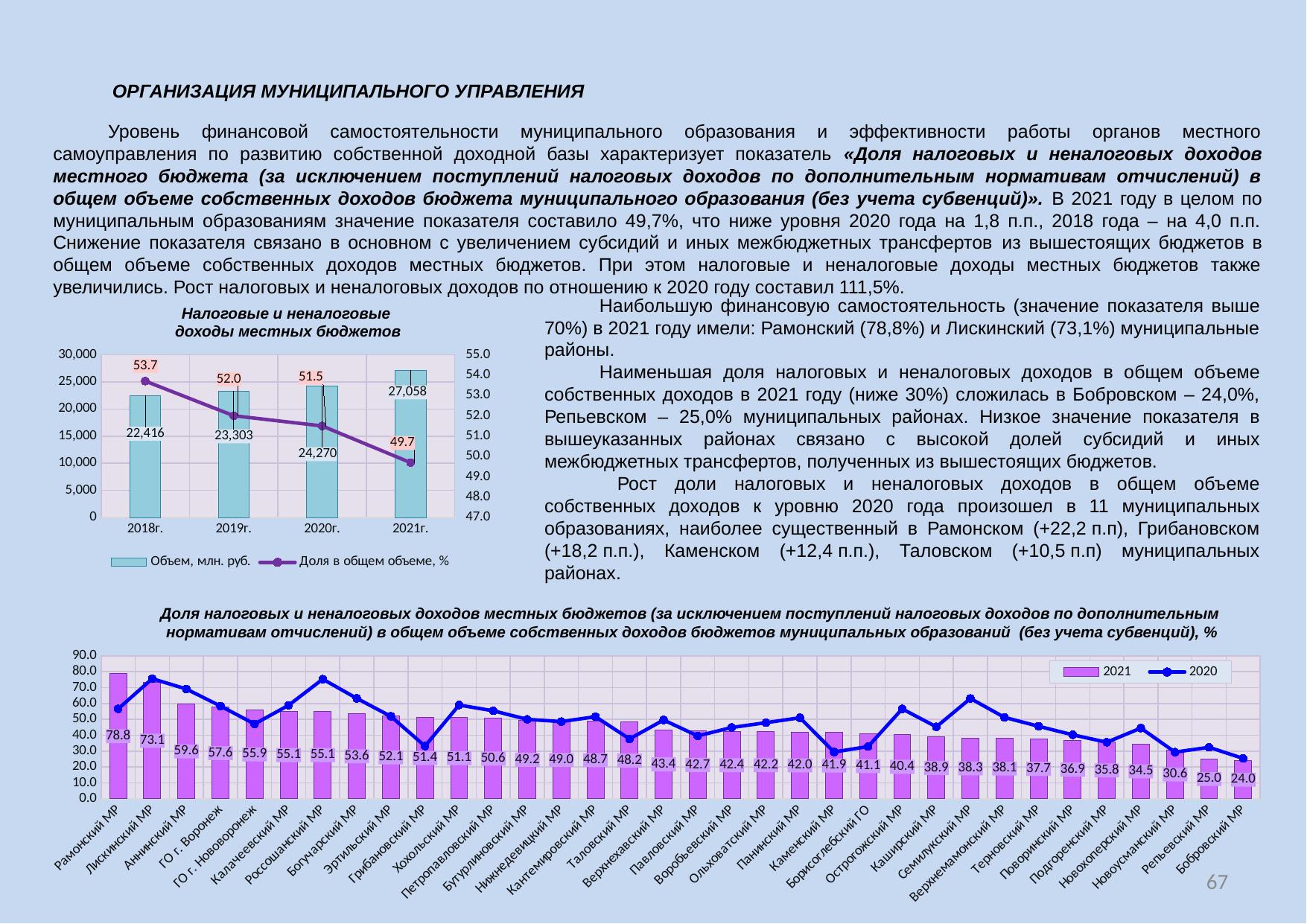
In the bottom chart 'Доля налоговых и неналоговых доходов местных бюджетов...', which category has the highest 2021 value? Рамонский МР In the bottom chart 'Доля налоговых и неналоговых доходов местных бюджетов...', what is the 2021 value for Лискинский МР? 73.1 In the bottom chart 'Доля налоговых и неналоговых доходов местных бюджетов...', what is the 2021 value for Репьевский МР? 25.0 In the chart 'Налоговые и неналоговые доходы местных бюджетов', how many series does the legend list? 2 In the chart 'Налоговые и неналоговые доходы местных бюджетов', what is the difference in 'Объем, млн. руб.' between 2021г. and 2020г.? 2,788 In the bottom chart 'Доля налоговых и неналоговых доходов местных бюджетов...', which category has the lowest 2021 value? Бобровский МР In the bottom chart 'Доля налоговых и неналоговых доходов местных бюджетов...', which is larger for 2021: Аннинский МР or Каширский МР? Аннинский МР In the bottom chart 'Доля налоговых и неналоговых доходов местных бюджетов...', what is the difference between the 2021 values for Рамонский МР and Бобровский МР? 54.8 In the chart 'Налоговые и неналоговые доходы местных бюджетов', what is the value of 'Объем, млн. руб.' for 2021г.? 27,058 In the chart 'Налоговые и неналоговые доходы местных бюджетов', what is the value of 'Доля в общем объеме, %' for 2018г.? 53.7 In the bottom chart 'Доля налоговых и неналоговых доходов местных бюджетов...', is the 2020 value for Рамонский МР greater or less than 50.0? greater In the chart 'Налоговые и неналоговые доходы местных бюджетов', does the 'Доля в общем объеме, %' line rise or fall from 2018г. to 2021г.? fall